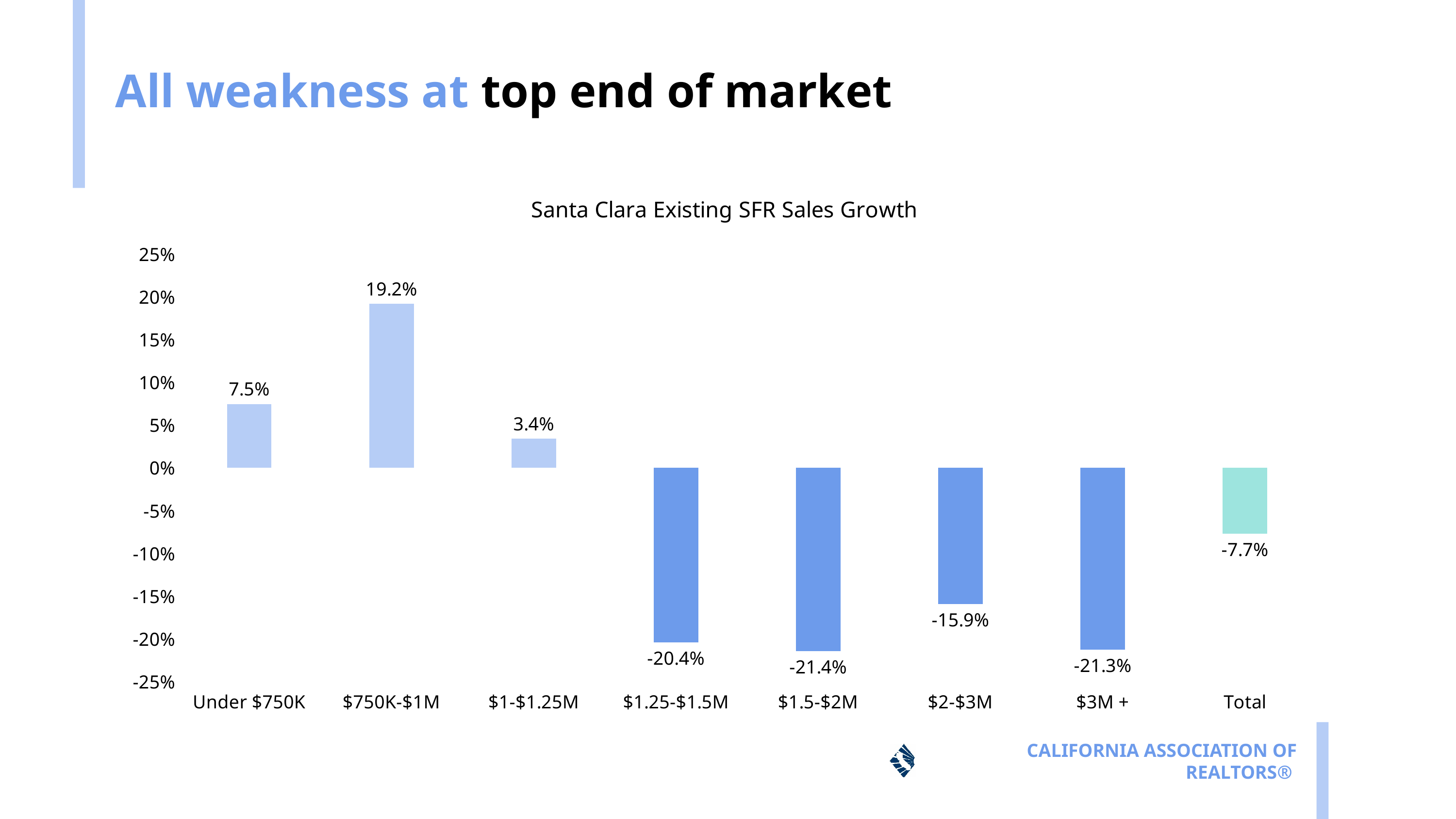
Which price range has the highest sales growth? $750K-$1M Which price range has the lowest sales growth? $1.5-$2M Is the sales growth for $1.25-$1.5M greater or less than -20%? less What is the Total sales growth shown on the chart? -7.7% Which has higher sales growth, Under $750K or $1-$1.25M? Under $750K What is the title of the chart? Santa Clara Existing SFR Sales Growth What is the difference between the sales growth for $750K-$1M and Under $750K? 11.7 percentage points How many price categories (including Total) are shown on the x axis? 8 What is the sales growth for the $750K-$1M price range? 19.2% What kind of chart is shown on the slide? Bar chart How many price ranges (excluding Total) show negative sales growth? 4 What is the sales growth for the $2-$3M price range? -15.9%